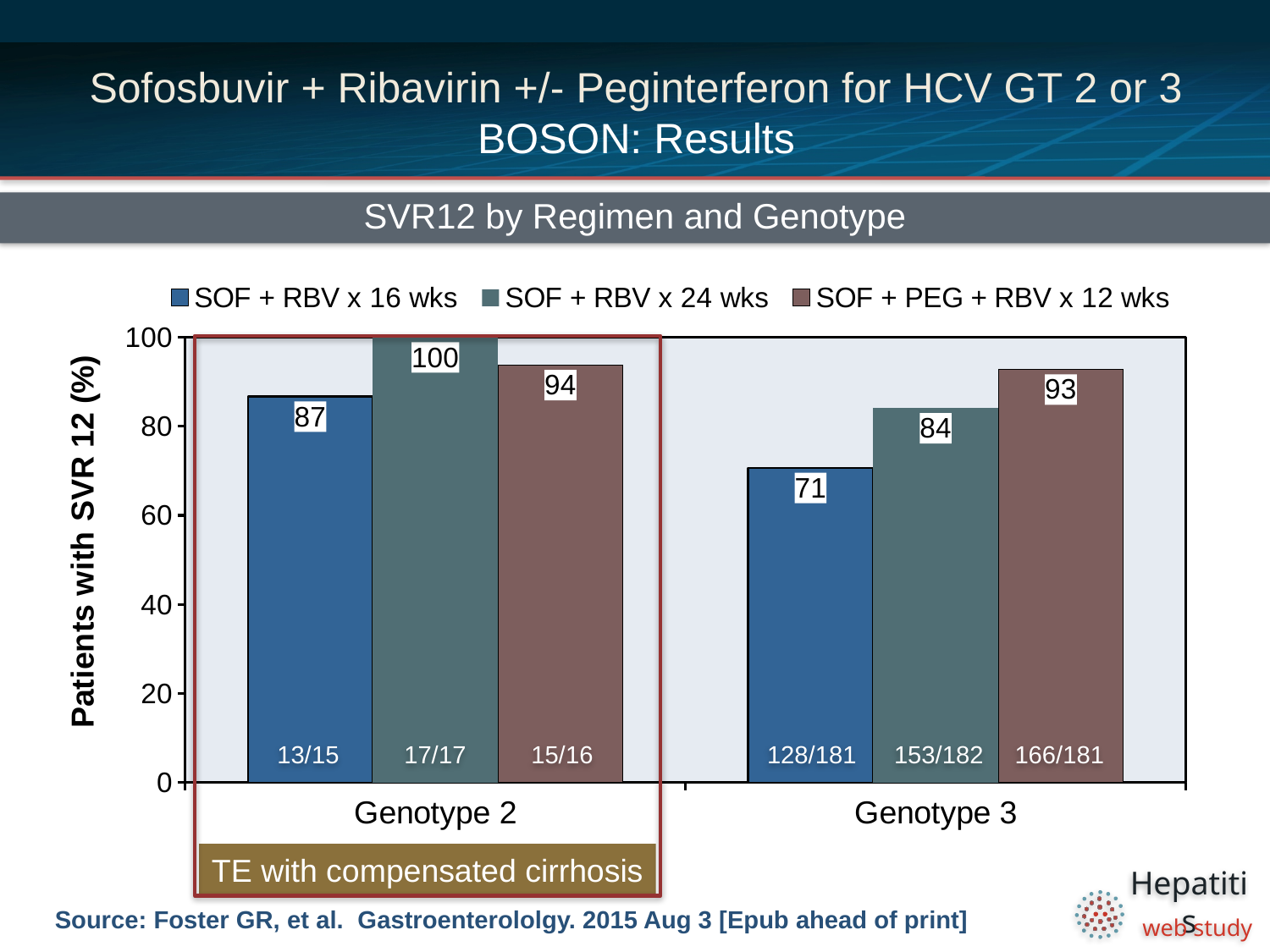
What kind of chart is shown? Bar chart What is the difference in SVR12 rate between SOF + PEG + RBV x 12 wks and SOF + RBV x 16 wks in Genotype 3? 22 What is the y-axis label of the chart? Patients with SVR 12 (%) Which regimen has the highest SVR12 rate in Genotype 2? SOF + RBV x 24 wks How many genotype categories are shown on the x axis? 2 Which is larger: the SVR12 rate for SOF + RBV x 24 wks in Genotype 2 or in Genotype 3? Genotype 2 How many series does the legend list? 3 What is the SVR12 rate for SOF + RBV x 24 wks in Genotype 3? 84 What is the SVR12 rate for SOF + PEG + RBV x 12 wks in Genotype 3? 93 Which regimen has the lowest SVR12 rate in Genotype 3? SOF + RBV x 16 wks What is the patient fraction shown for SOF + RBV x 16 wks in Genotype 3? 128/181 What is the SVR12 rate for SOF + RBV x 16 wks in Genotype 2? 87